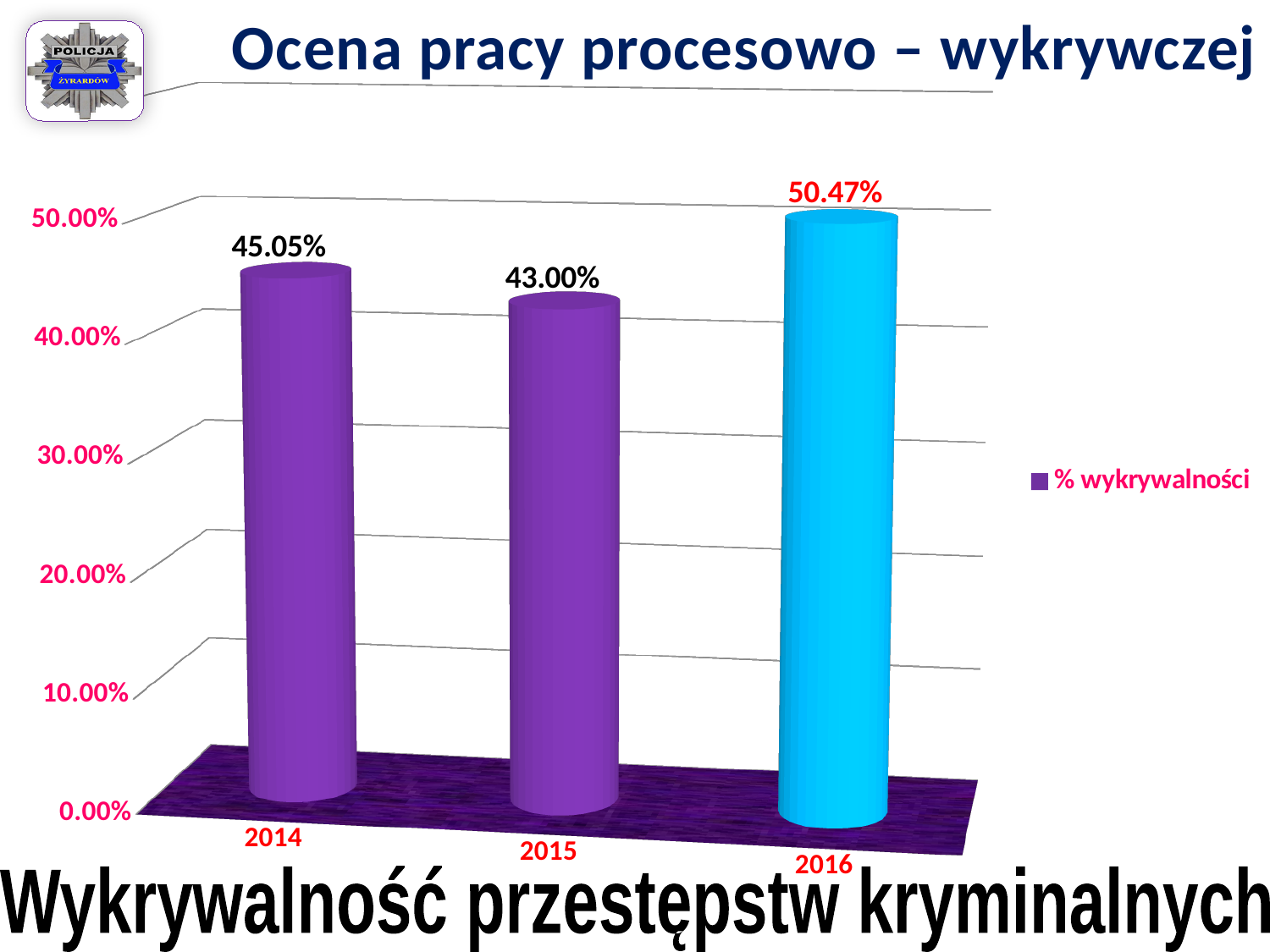
What is the difference between the values for 2014 and 2015? 2.05% Is the value for 2016 greater or less than 50.00%? greater Which year has the highest value? 2016 What series name does the legend list? % wykrywalności What is the value for 2014? 45.05% Which year has the lowest value? 2015 Which is larger, the value for 2014 or the value for 2016? 2016 How many years are shown on the x axis? 3 What is the value for 2015? 43.00% What kind of chart is shown on the slide? bar chart What is the value for 2016? 50.47% What is the difference between the values for 2016 and 2015? 7.47%